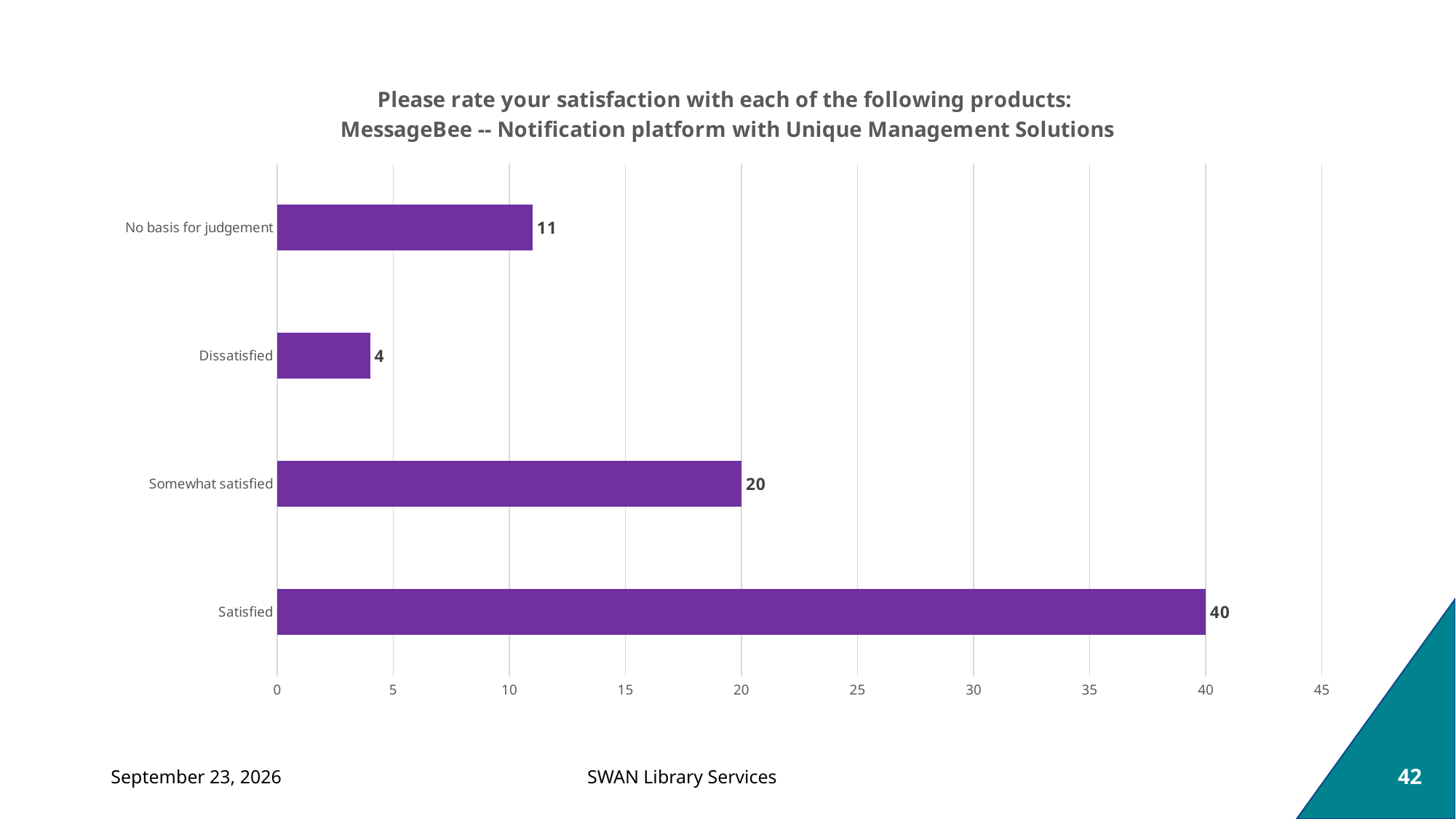
Which category has the lowest value? Dissatisfied How many categories are shown in the chart? 4 What is the difference between the values for No basis for judgement and Dissatisfied? 7 What is the value for Somewhat satisfied? 20 Which is larger, the value for No basis for judgement or the value for Somewhat satisfied? Somewhat satisfied Which category has the highest value? Satisfied What is the difference between the values for Satisfied and Somewhat satisfied? 20 What is the value for No basis for judgement? 11 What kind of chart is shown on the slide? Bar chart What is the value for Satisfied? 40 What is the value for Dissatisfied? 4 Which product is the chart about? MessageBee -- Notification platform with Unique Management Solutions